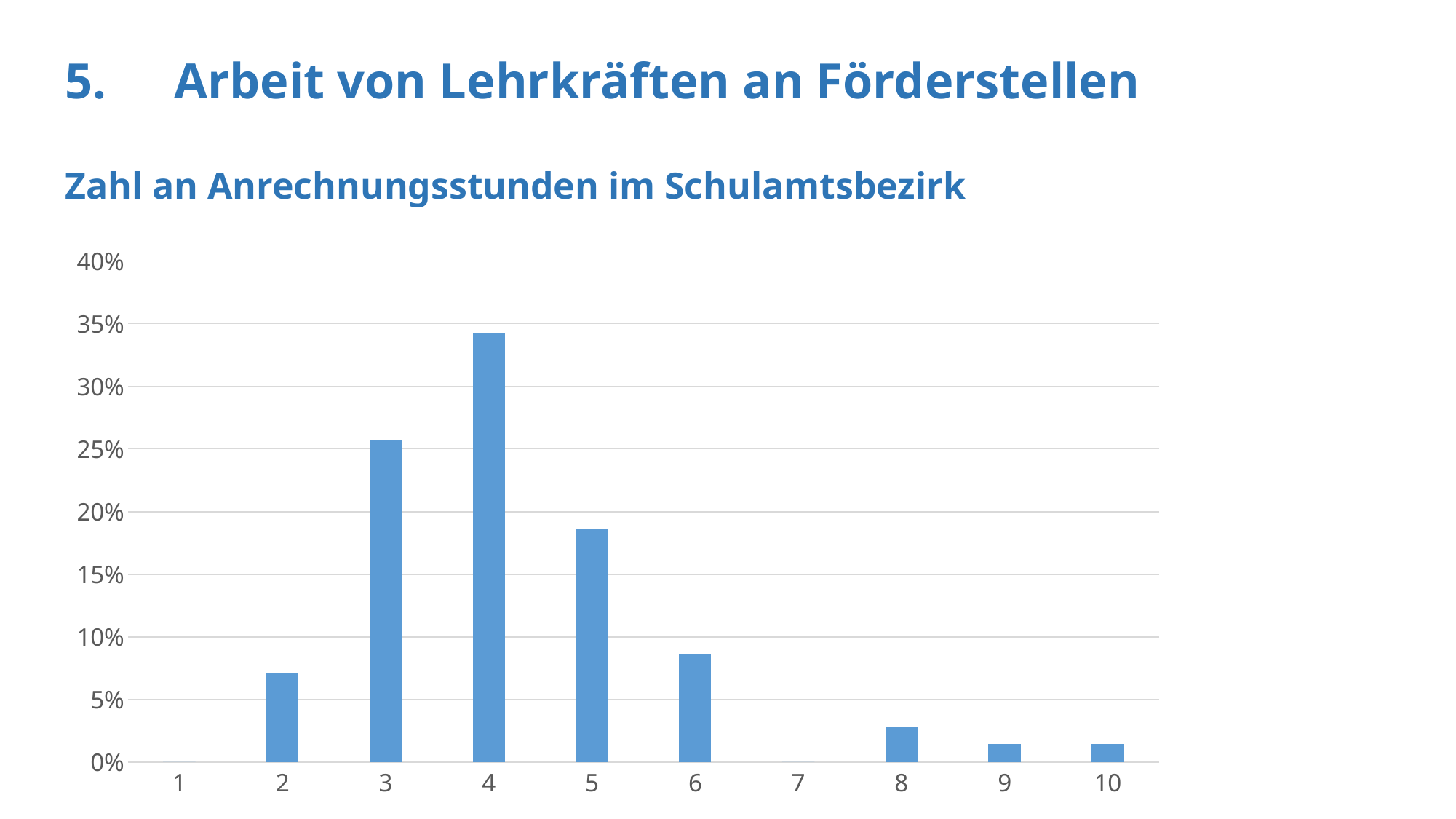
What kind of chart is shown on the slide? bar chart What is the title of the chart? Zahl an Anrechnungsstunden im Schulamtsbezirk Which has the larger value, category 3 or category 5? 3 Is the value for category 2 greater or less than 5%? greater How many categories are shown on the x axis? 10 Which category has the highest value? 4 Is the value for category 6 greater or less than 10%? less Is the value for category 4 greater or less than 30%? greater Which has the larger value, category 2 or category 6? 6 Do the values rise or fall from category 4 to category 6? fall